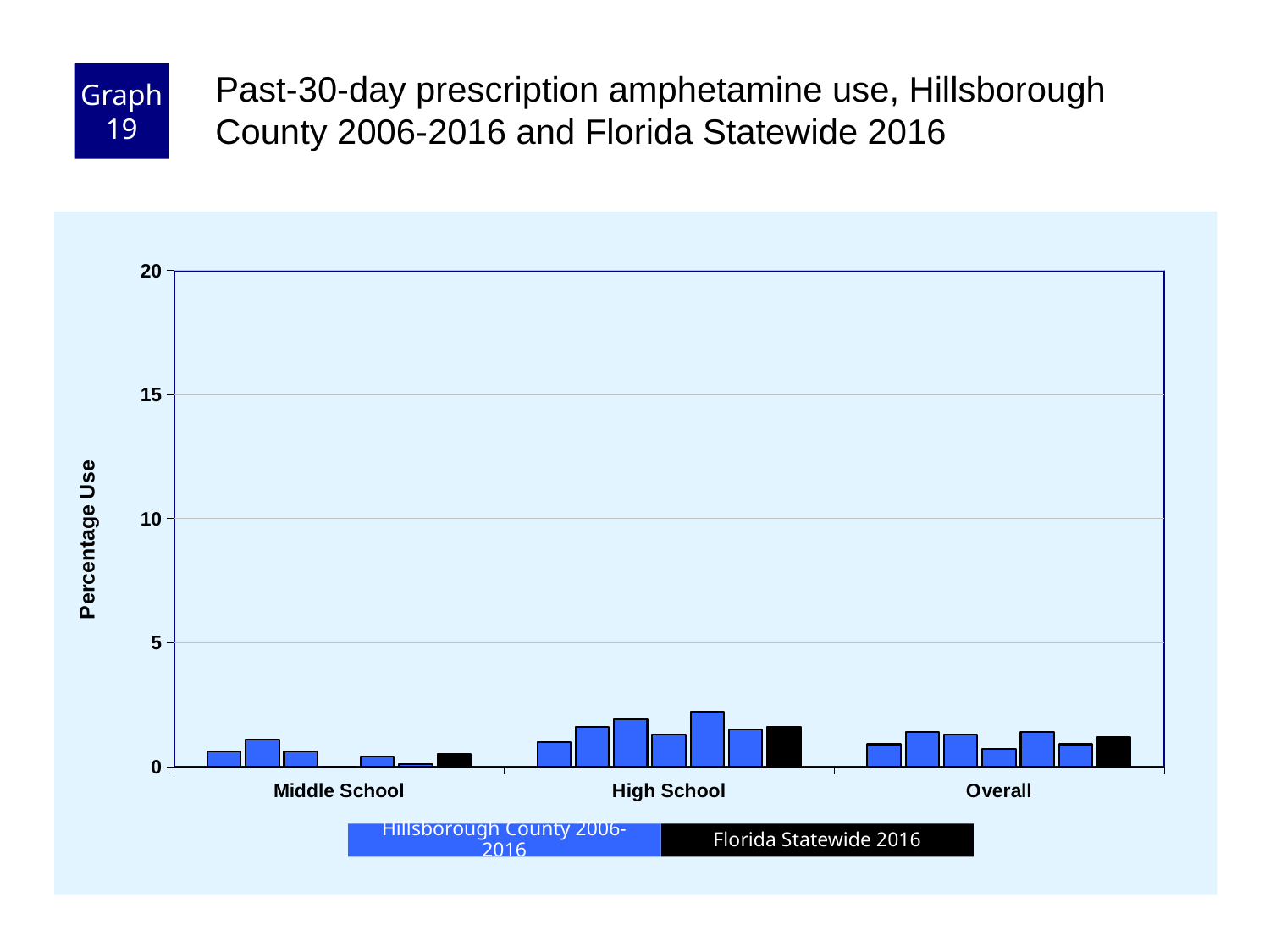
How many school-level categories are shown on the x axis? 3 How many series does the legend list? 2 Which category has the highest bars overall? High School Which series is shown in black in the legend? Florida Statewide 2016 Which is larger, the Florida Statewide 2016 value for High School or for Middle School? High School Is the Florida Statewide 2016 value for High School greater or less than 5? less Is the Florida Statewide 2016 value for Overall greater or less than 5? less What is the highest value shown on the y axis? 20 Is the Florida Statewide 2016 value for Middle School greater or less than 5? less What is the label on the y axis? Percentage Use What kind of chart is shown on the slide? Bar chart Which category has the lowest bars overall? Middle School